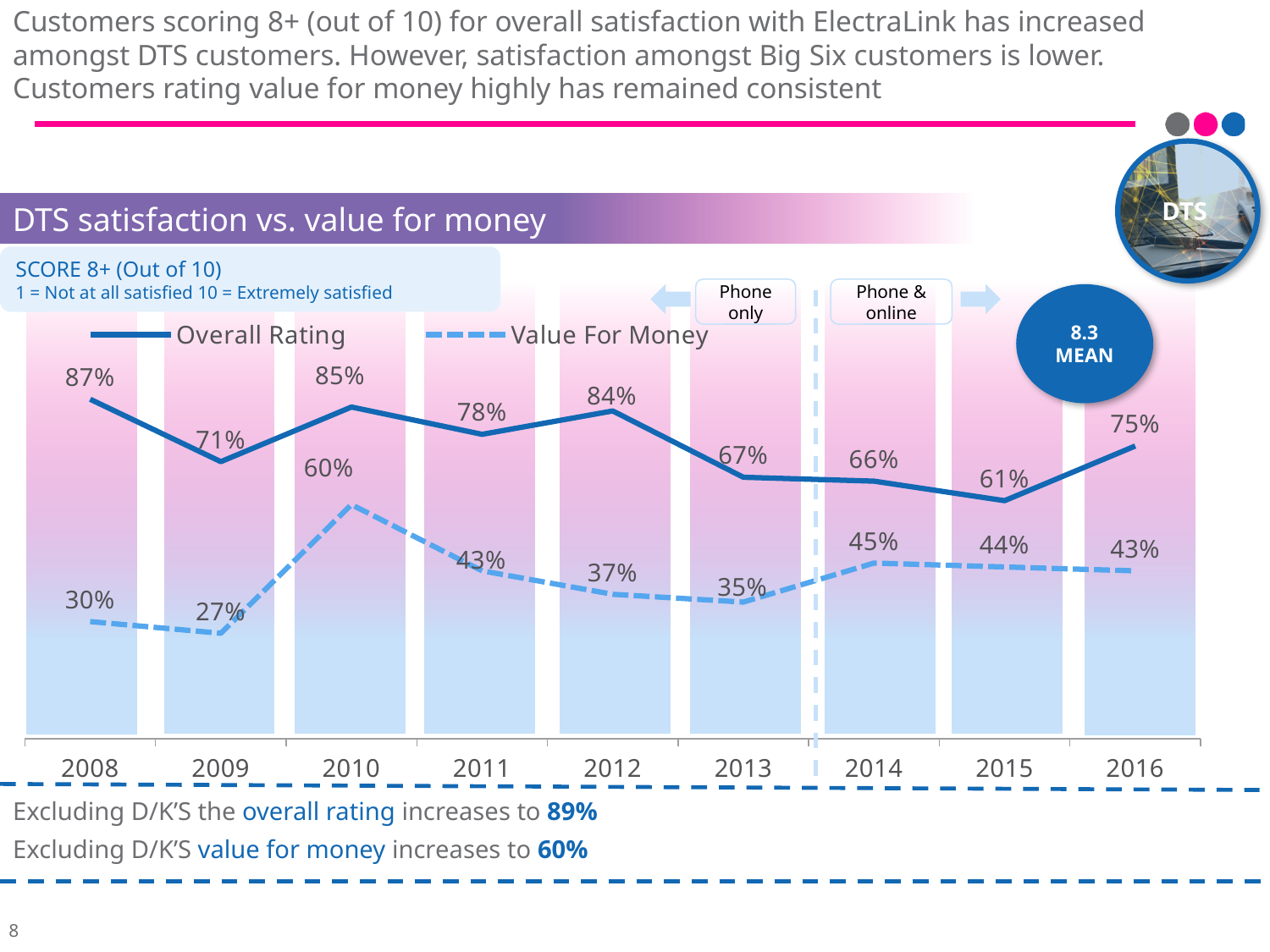
How many series does the legend list? 2 In which year is the Overall Rating lowest? 2015 What is the Value For Money value for 2010? 60% Which is larger, the Overall Rating in 2012 or the Overall Rating in 2013? 2012 What is the Overall Rating value for 2008? 87% What is the Overall Rating value for 2016? 75% In which year is the Value For Money value highest? 2010 What is the difference between the Overall Rating and Value For Money values in 2008? 57% How many years are shown on the x axis? 9 What type of chart is shown? Line chart What is the Value For Money value for 2014? 45% In which year is the Value For Money value lowest? 2009